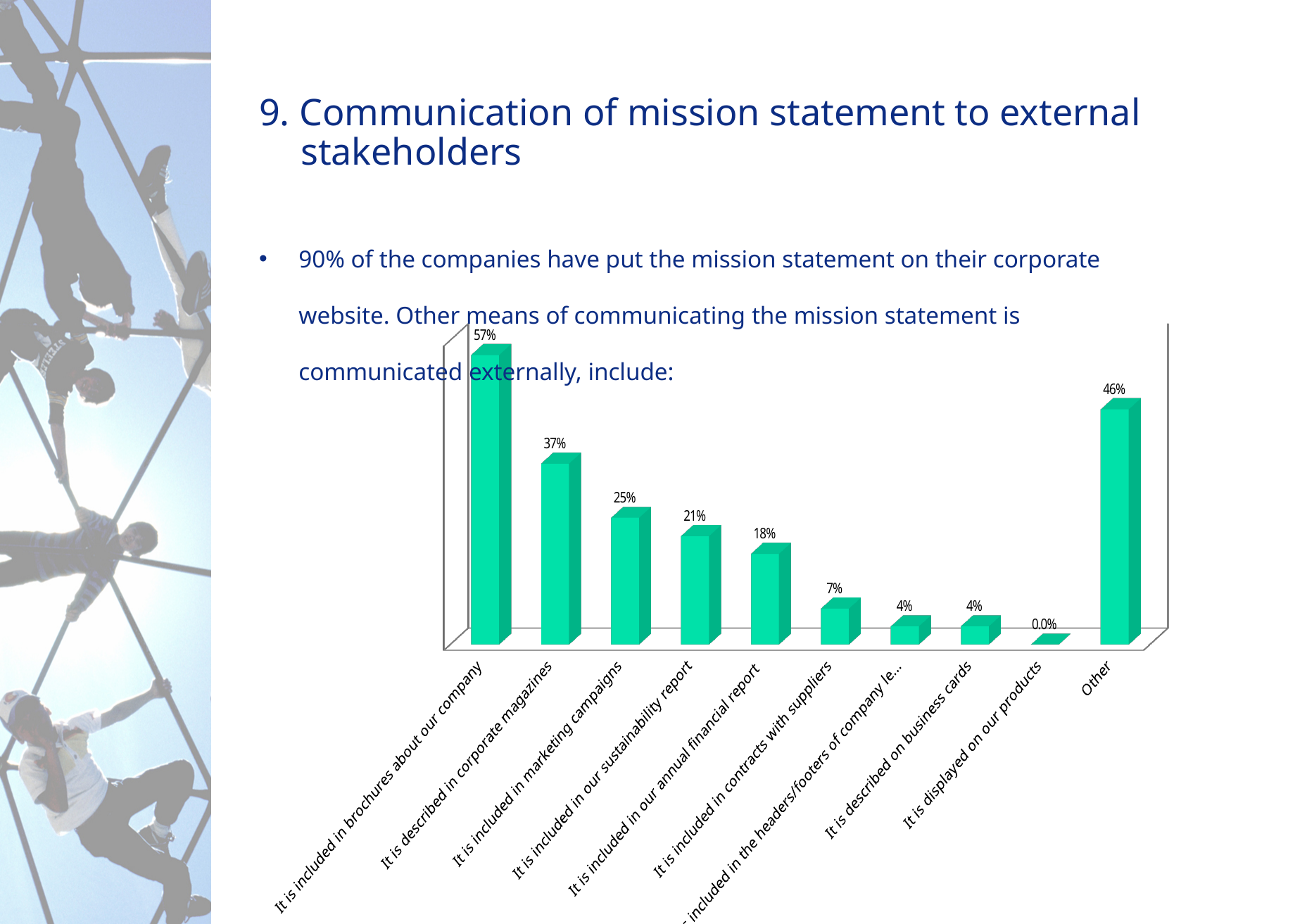
What is the value for 'It is described in corporate magazines'? 37% Which category has the lowest value? It is displayed on our products Which is larger: the value for 'It is described in corporate magazines' or the value for 'Other'? Other What percentage of companies include the mission statement in brochures about the company? 57% How many categories are shown in the chart? 10 What is the difference between 'It is included in marketing campaigns' and 'It is included in our sustainability report'? 4% What kind of chart is shown on the slide? Bar chart Which category has the highest value? It is included in brochures about our company What is the value for 'Other'? 46% What is the value for 'It is displayed on our products'? 0.0% What is the value for 'It is included in our annual financial report'? 18% What is the difference between the values for 'It is included in brochures about our company' and 'Other'? 11%